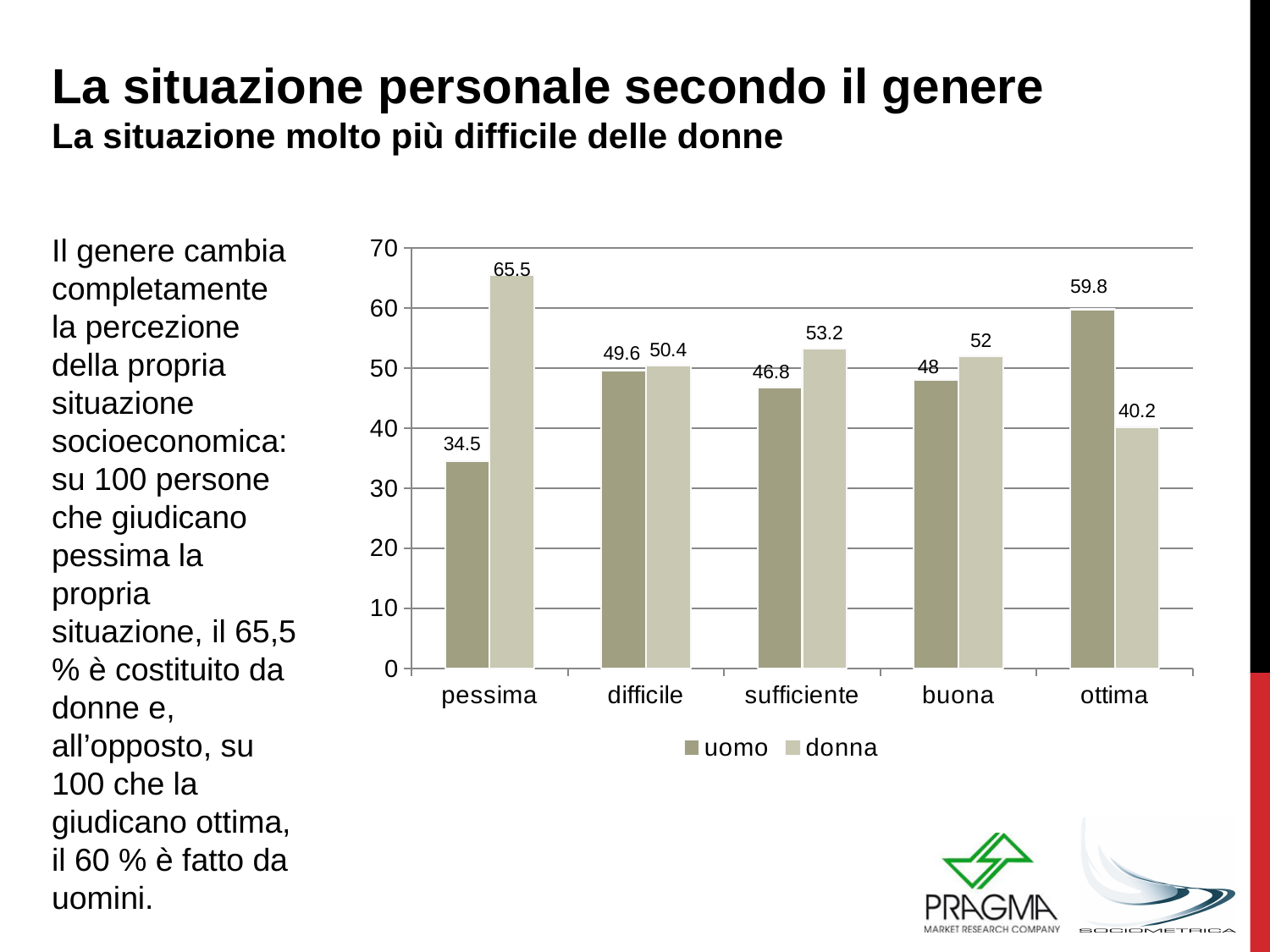
What is the value for 'uomo' in the 'ottima' category? 59.8 In the 'buona' category, which series has the larger value, 'uomo' or 'donna'? donna How many series does the legend list? 2 What is the value for 'uomo' in the 'sufficiente' category? 46.8 Which series is shown in the darker colour? uomo What is the difference between the 'uomo' and 'donna' values in the 'ottima' category? 19.6 How many categories are shown on the x axis? 5 Which category has the highest value for 'donna'? pessima Which category has the lowest value for 'uomo'? pessima What kind of chart is shown on the slide? bar chart What is the difference between the 'donna' and 'uomo' values in the 'pessima' category? 31 What is the value for 'donna' in the 'pessima' category? 65.5